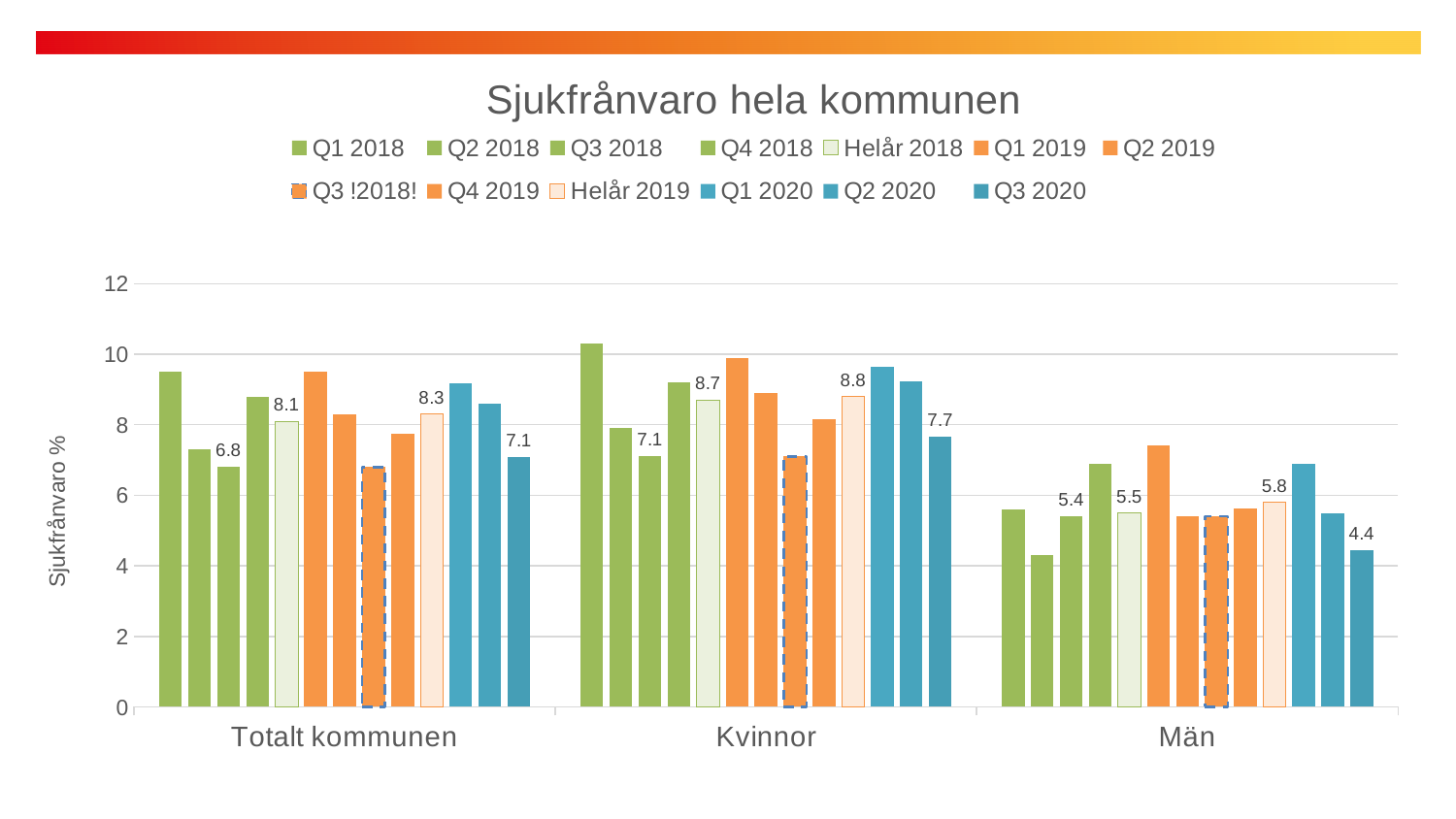
How many series does the legend list? 13 What is the difference between the Helår 2019 and Helår 2018 values for Totalt kommunen? 0.2 Which category has the highest Helår 2019 value? Kvinnor What is the value for Q3 2020 in the Män category? 4.4 Is the value for Q2 2018 in the Män category greater or less than 6? less What is the difference between the Q3 2020 values for Kvinnor and Män? 3.3 What is the value for Helår 2018 in the Totalt kommunen category? 8.1 Which category has the lowest Q3 2020 value? Män How many categories are shown on the x axis? 3 Is the value for Q1 2018 in the Kvinnor category greater or less than 10? greater Which is larger, the Q3 2018 value for Kvinnor or for Totalt kommunen? Kvinnor What is the value for Helår 2019 in the Kvinnor category? 8.8